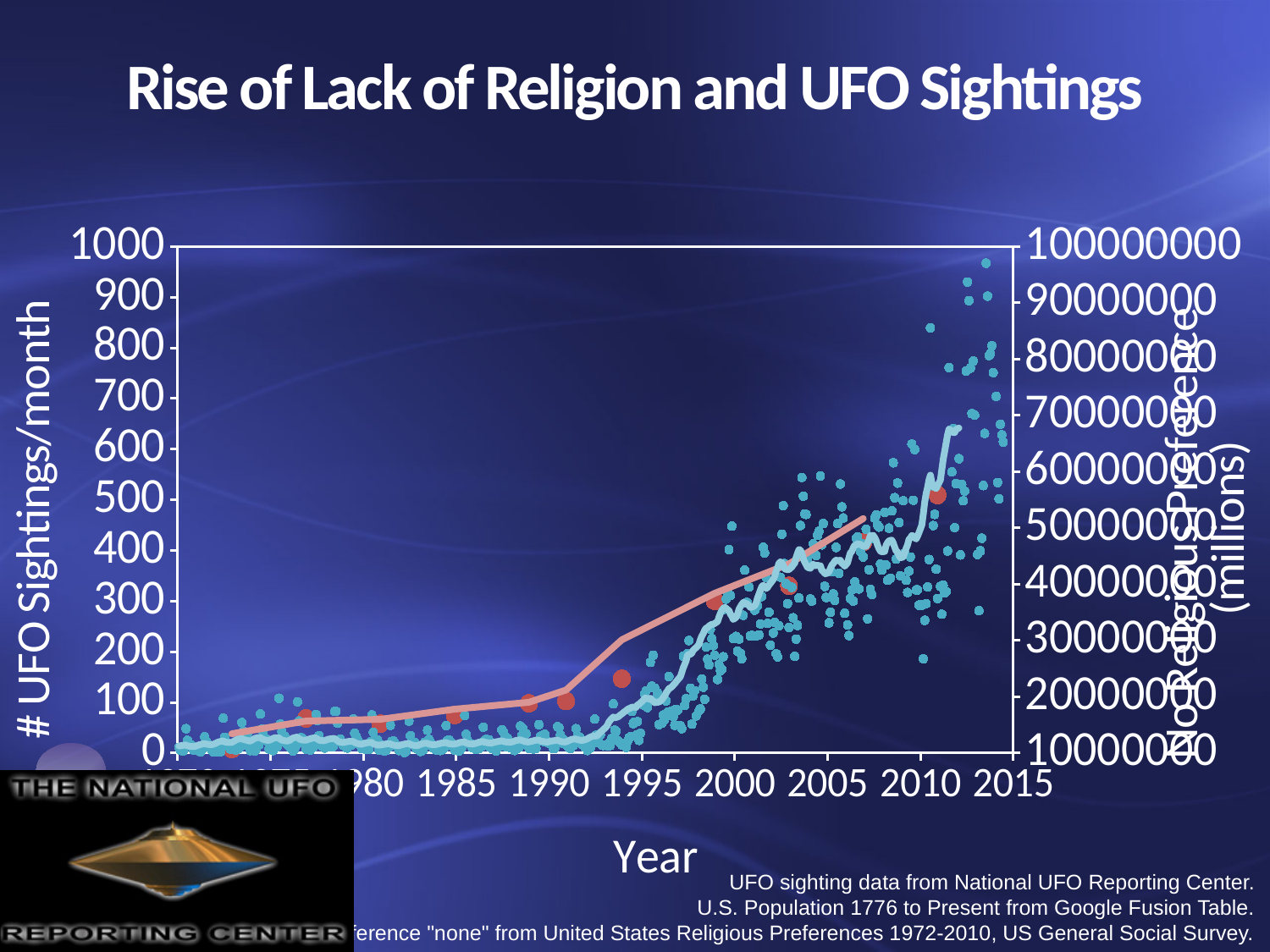
Is the UFO sightings per month trend line value around 2013 greater or less than 500? greater Is the UFO sightings per month trend line value around 1990 greater or less than 100? less Do the UFO sightings per month generally rise or fall from 1980 to 2015? rise Is the UFO sightings per month trend line higher in 2010 or in 1995? 2010 What kind of chart is shown on the slide? scatter chart Is the UFO sightings per month trend line value around 1985 greater or less than 200? less What is the title of the chart? Rise of Lack of Religion and UFO Sightings What is the label of the left vertical axis? # UFO Sightings/month